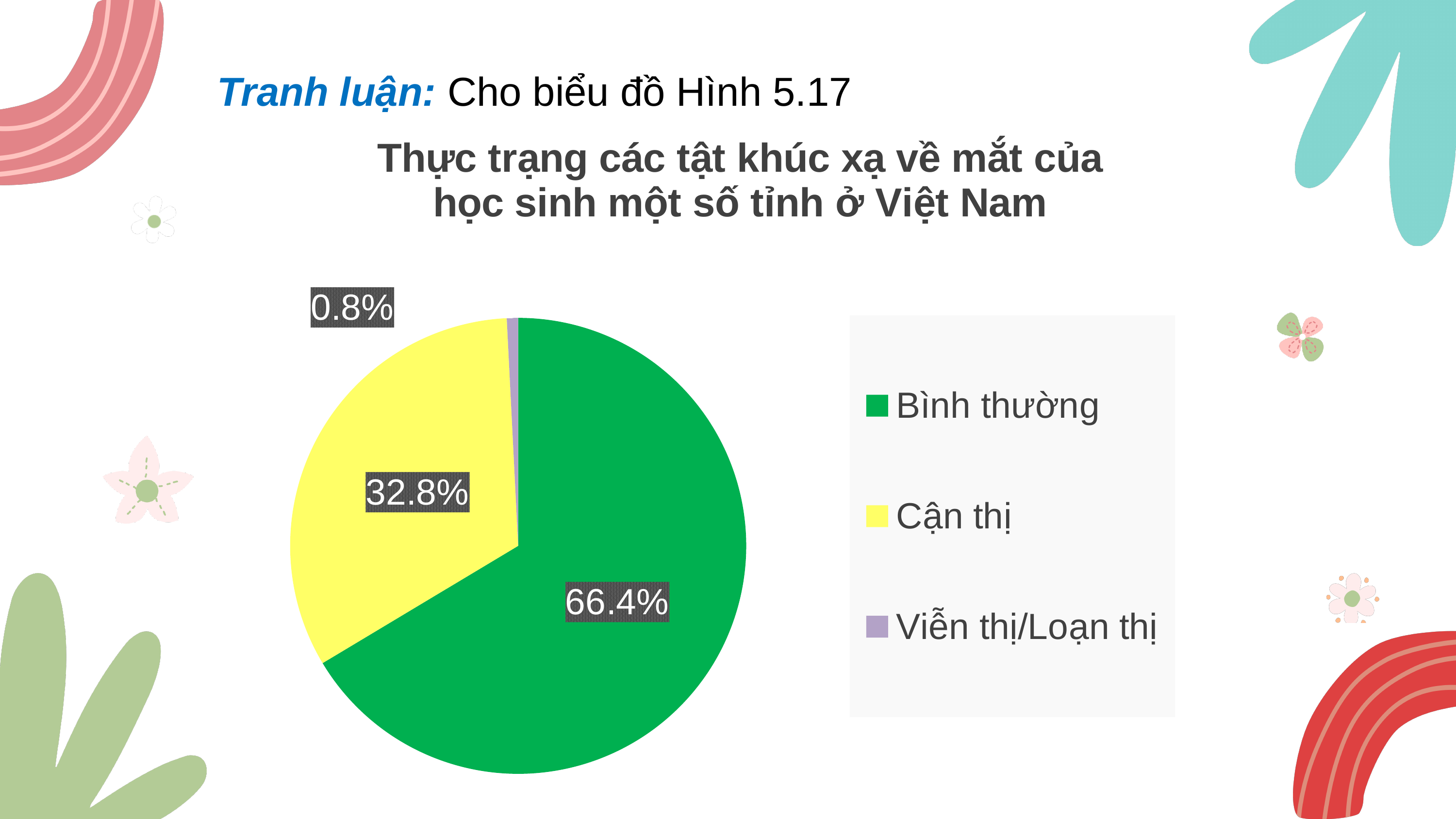
How many categories does the pie chart have? 3 What is the value for Cận thị? 32.8% What is the difference between the values for Cận thị and Viễn thị/Loạn thị? 32.0% What is the title of the chart? Thực trạng các tật khúc xạ về mắt của học sinh một số tỉnh ở Việt Nam What is the difference between the values for Bình thường and Cận thị? 33.6% Which category has the smallest share of the pie? Viễn thị/Loạn thị What type of chart is shown on the slide? pie chart Which category has the largest share of the pie? Bình thường What is the value for Viễn thị/Loạn thị? 0.8% Which is larger, the value for Cận thị or the value for Viễn thị/Loạn thị? Cận thị What colour is the slice for Cận thị? yellow What is the value for Bình thường? 66.4%